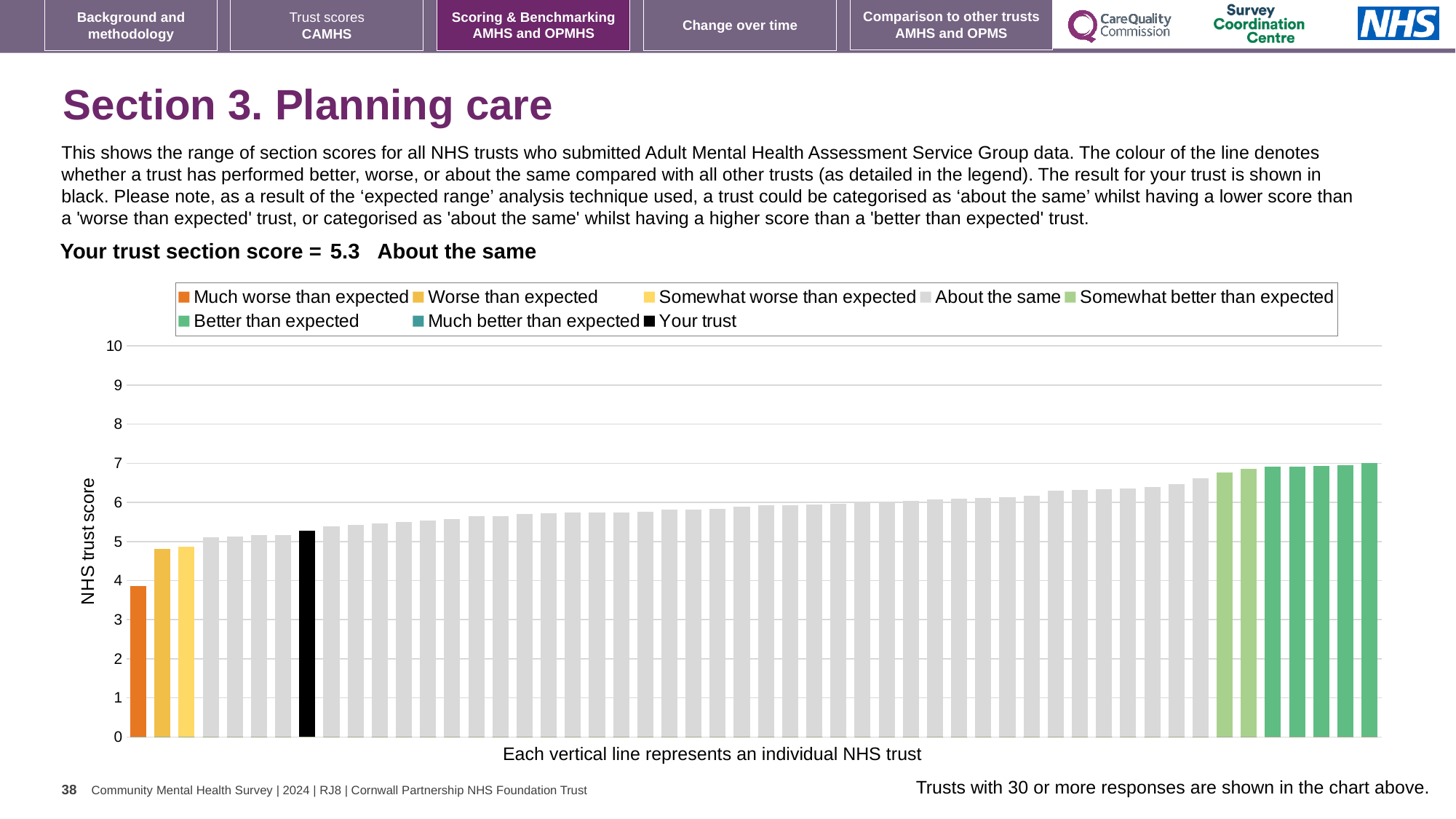
What is your trust's section score for Planning care? 5.3 Is the value for the lowest bar (Much worse than expected) greater or less than 5? less What kind of chart is shown on the slide? bar chart What is the label on the vertical axis of the chart? NHS trust score Which legend category does the highest bar belong to? Better than expected How many entries does the chart legend list? 8 How many bars are coloured as 'Much worse than expected'? 1 Which legend category does the lowest bar belong to? Much worse than expected Is the Your trust bar higher or lower than the 'Much worse than expected' bar? higher Do the bar values rise or fall from left to right along the x axis? rise Is the value for Your trust greater or less than 5? greater Is the value for the highest bar greater or less than 6? greater